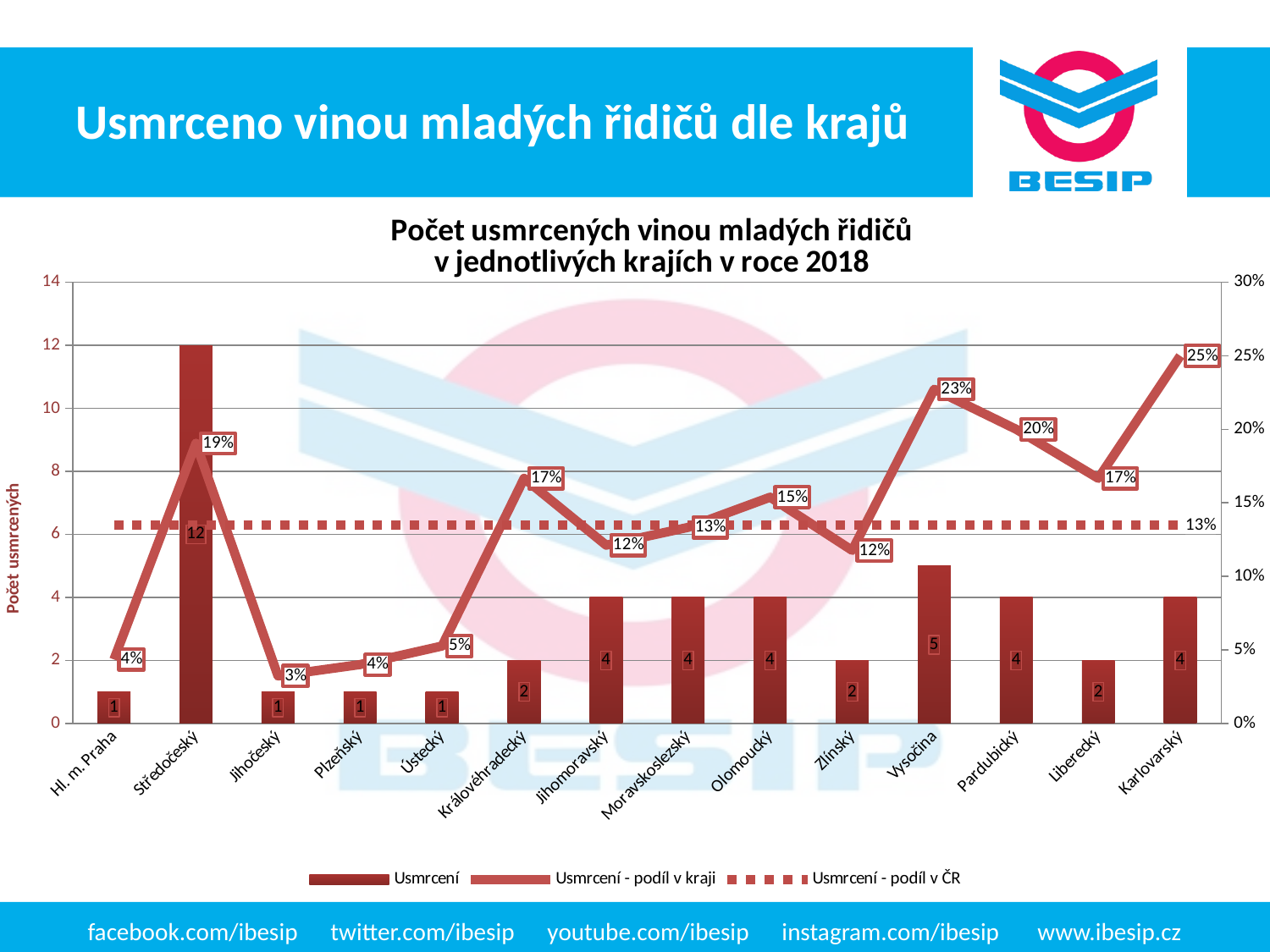
How many deaths (Usmrcení) are shown for Středočeský? 12 What value does the dotted 'Usmrcení - podíl v ČR' line show? 13% How many series does the legend list? 3 Which region has the lowest 'Usmrcení - podíl v kraji' value? Jihočeský What is the difference in deaths (Usmrcení) between Středočeský and Vysočina? 7 Which region has the highest number of deaths (Usmrcení)? Středočeský How many regions are shown on the x axis? 14 What is the difference between the 'podíl v kraji' values for Karlovarský and Liberecký? 8% What is the 'Usmrcení - podíl v kraji' value for Vysočina? 23% What is the title of the chart? Počet usmrcených vinou mladých řidičů v jednotlivých krajích v roce 2018 What is the 'Usmrcení - podíl v kraji' value for Karlovarský? 25% Which has more deaths (Usmrcení): Vysočina or Pardubický? Vysočina